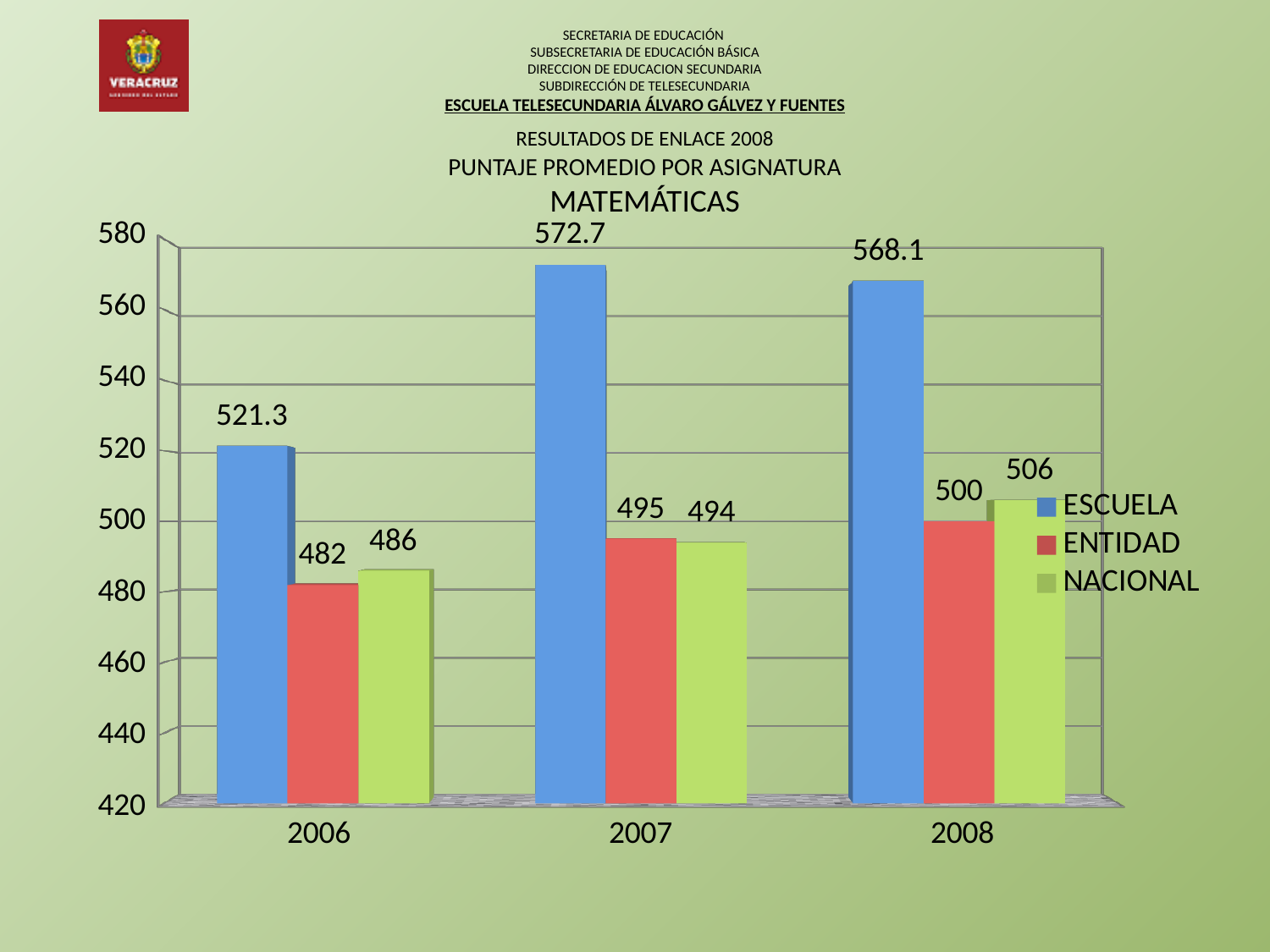
Is the ESCUELA value for 2006 greater or less than 500? greater Which is larger in 2007, the ENTIDAD value or the NACIONAL value? ENTIDAD What is the difference between the ESCUELA and ENTIDAD values in 2008? 68.1 In which year is the NACIONAL value lowest? 2006 What is the ENTIDAD value for 2006? 482 What kind of chart is shown? bar chart In which year is the ESCUELA value highest? 2007 Does the ENTIDAD value rise or fall from 2006 to 2008? rise What is the NACIONAL value for 2008? 506 How many series does the legend list? 3 How many years are shown on the x axis? 3 What is the ESCUELA value for 2007? 572.7